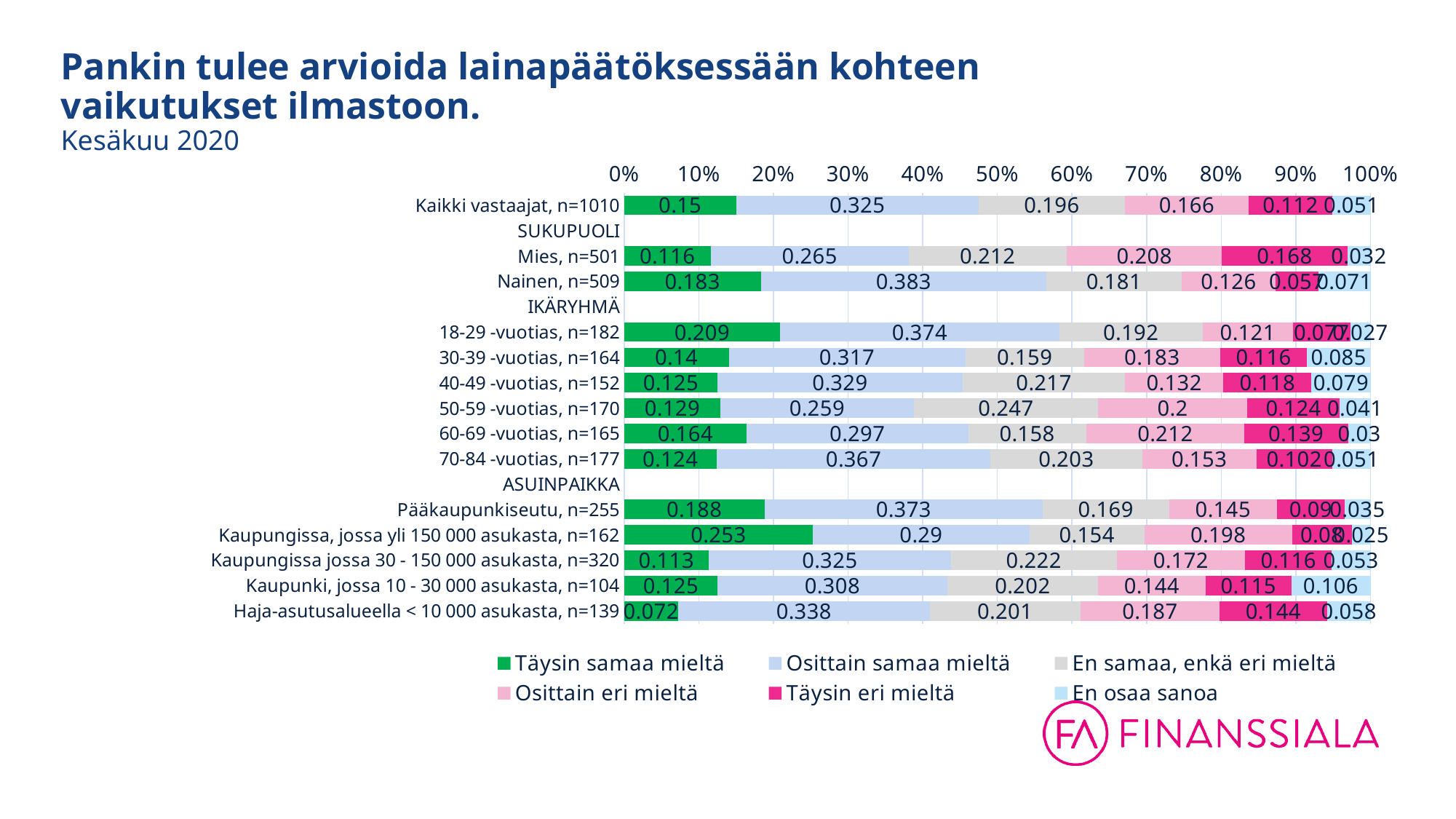
What is the difference in 'Täysin samaa mieltä' between 'Nainen, n=509' and 'Mies, n=501'? 0.067 What is the value of 'Osittain samaa mieltä' for 'Nainen, n=509'? 0.383 Which group has the lowest 'Täysin samaa mieltä' value? Haja-asutusalueella < 10 000 asukasta, n=139 What kind of chart is shown on the slide? Stacked bar chart Which has the larger 'Täysin eri mieltä' value, 'Mies, n=501' or 'Nainen, n=509'? Mies, n=501 Which group has the highest 'En osaa sanoa' value? Kaupunki, jossa 10 - 30 000 asukasta, n=104 How many series does the legend list? 6 What is the value of 'En osaa sanoa' for 'Kaupunki, jossa 10 - 30 000 asukasta, n=104'? 0.106 Which group has the highest 'Täysin samaa mieltä' value? Kaupungissa, jossa yli 150 000 asukasta, n=162 What is the value of 'Osittain eri mieltä' for '60-69 -vuotias, n=165'? 0.212 What is the title of the slide? Pankin tulee arvioida lainapäätöksessään kohteen vaikutukset ilmastoon. What is the value of 'Täysin samaa mieltä' for 'Kaikki vastaajat, n=1010'? 0.15